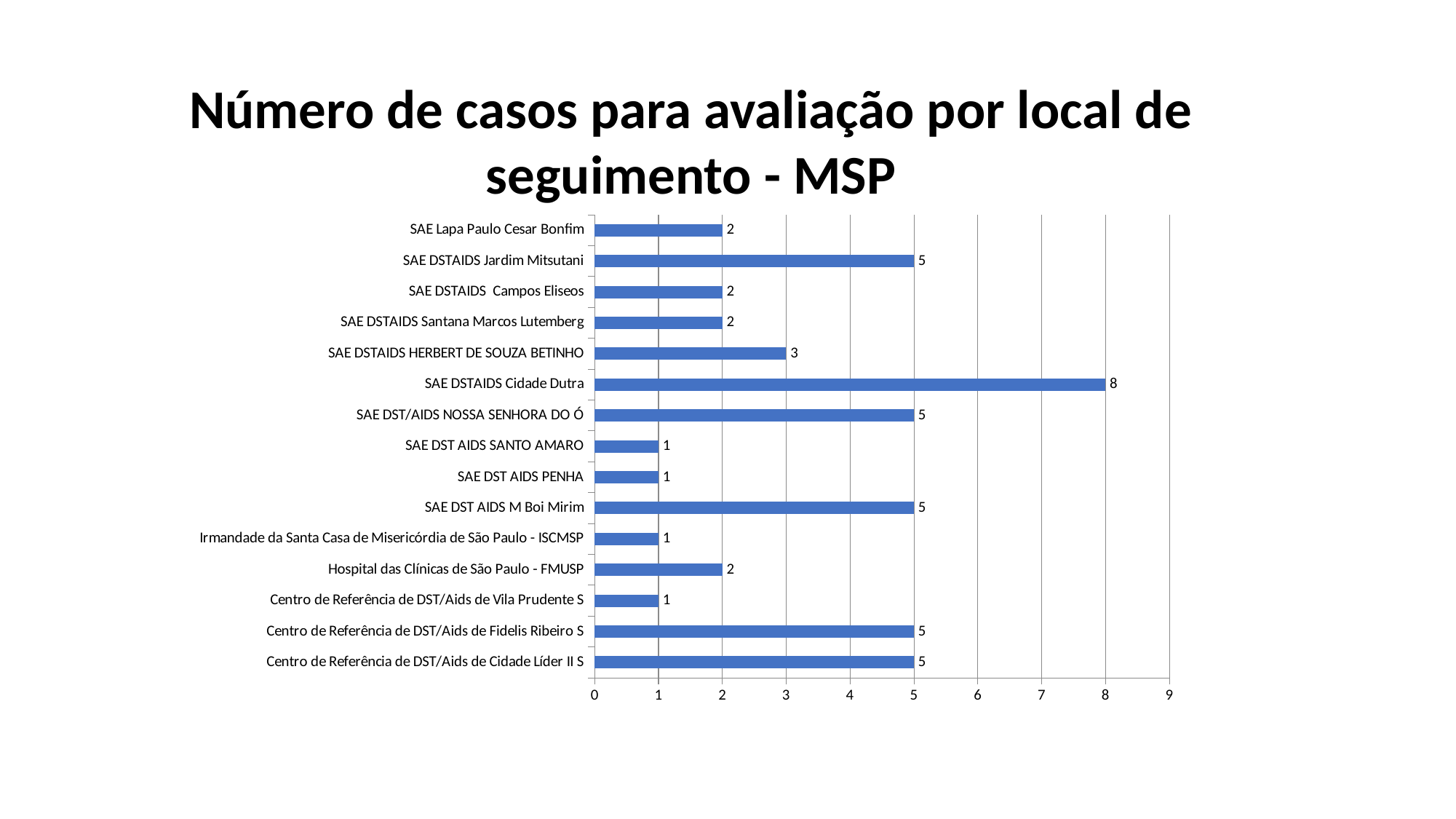
What is the value for SAE DSTAIDS HERBERT DE SOUZA BETINHO? 3 What kind of chart is shown on the slide? bar chart Is the value for SAE DSTAIDS Cidade Dutra greater or less than 6? greater Which is larger, the value for SAE DSTAIDS HERBERT DE SOUZA BETINHO or the value for SAE Lapa Paulo Cesar Bonfim? SAE DSTAIDS HERBERT DE SOUZA BETINHO What is the value for SAE DST AIDS PENHA? 1 What is the difference between the values for SAE DST AIDS M Boi Mirim and SAE DST AIDS SANTO AMARO? 4 What is the value for SAE DSTAIDS Cidade Dutra? 8 What is the title of the chart? Número de casos para avaliação por local de seguimento - MSP What is the value for Hospital das Clínicas de São Paulo - FMUSP? 2 How many categories are shown on the chart? 15 What is the difference between the values for SAE DSTAIDS Cidade Dutra and SAE DSTAIDS Jardim Mitsutani? 3 Which category has the highest value? SAE DSTAIDS Cidade Dutra